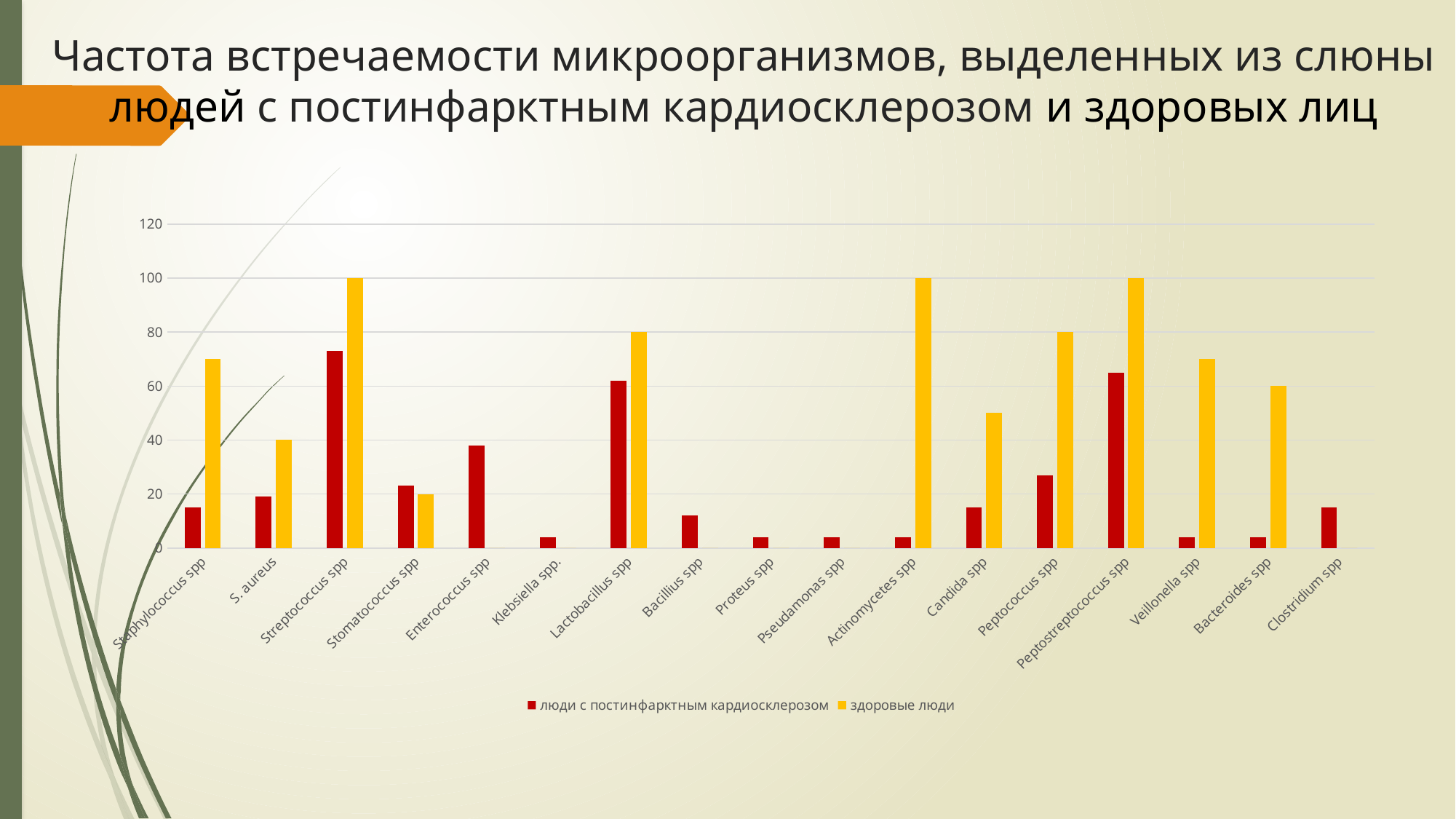
What is the value for здоровые люди for Streptococcus spp? 100 What is the value for здоровые люди for Bacteroides spp? 60 Which series has the larger value for Stomatococcus spp? люди с постинфарктным кардиосклерозом How many microorganism categories are shown on the x axis? 17 What kind of chart is shown on the slide? bar chart Which category has the highest value for люди с постинфарктным кардиосклерозом? Streptococcus spp What is the value for здоровые люди for Lactobacillus spp? 80 What colour are the bars for здоровые люди? yellow How many series does the legend list? 2 What is the value for здоровые люди for S. aureus? 40 Is the value for люди с постинфарктным кардиосклерозом for Streptococcus spp greater or less than 60? greater